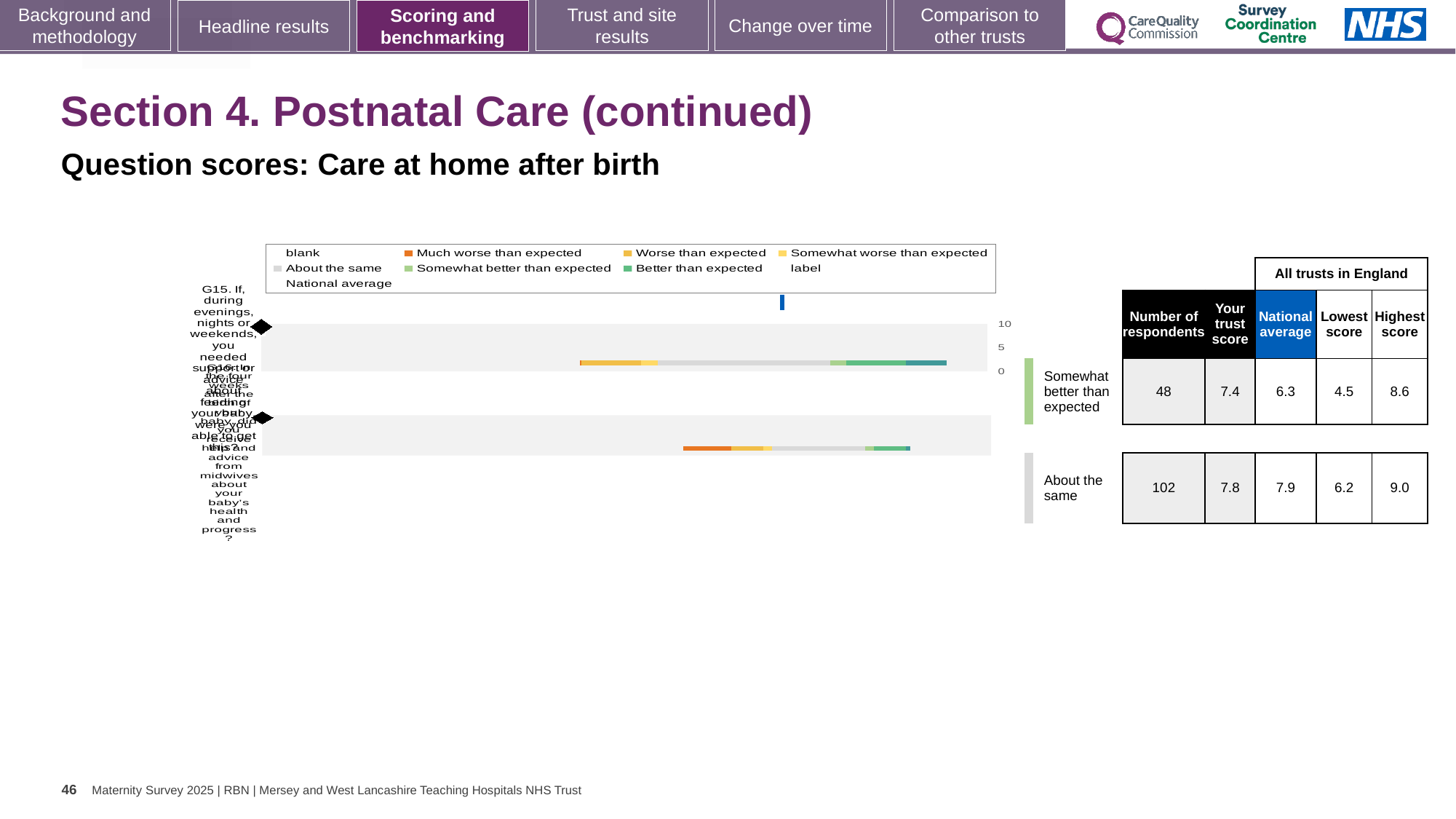
In the table beside the chart, what is the national average for the row rated 'About the same'? 7.9 For the row rated 'About the same', what is the difference between the national average and the trust score? 0.1 What colour does the chart legend use for 'Much worse than expected'? orange How many bars (questions) are plotted in the chart? 2 In the table beside the chart, how many respondents are listed for the row rated 'About the same'? 102 For the row rated 'Somewhat better than expected', which is larger: the trust score or the national average? the trust score In the table beside the chart, what is the 'Your trust score' for the row rated 'Somewhat better than expected'? 7.4 How many more respondents are there for the 'About the same' row than for the 'Somewhat better than expected' row? 54 What kind of chart is shown on the slide? bar chart In the table beside the chart, what is the lowest score for the row rated 'About the same'? 6.2 Which row in the table has the larger number of respondents? About the same In the table beside the chart, what is the highest score for the row rated 'Somewhat better than expected'? 8.6